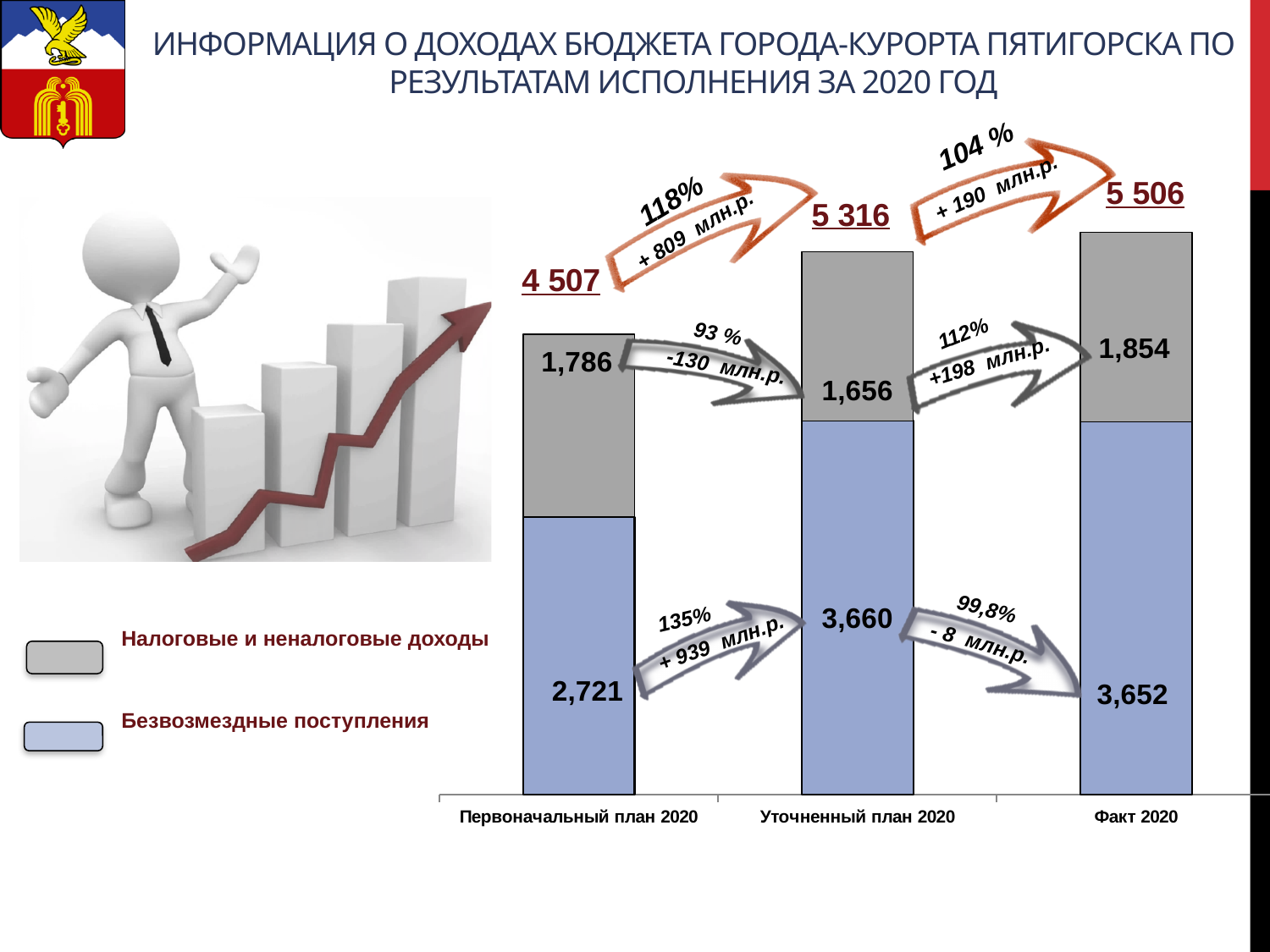
Which category has the lowest value for Безвозмездные поступления? Первоначальный план 2020 What is the value of Безвозмездные поступления for Уточненный план 2020? 3,660 Which category has the highest value for Налоговые и неналоговые доходы? Факт 2020 What is the total of the stacked bar for Факт 2020? 5 506 What is the total of the stacked bar for Первоначальный план 2020? 4 507 What type of chart is shown on the slide? stacked bar chart How many series does the legend list? 2 How many categories are shown along the x axis of the chart? 3 What is the value of Безвозмездные поступления for Факт 2020? 3,652 What is the difference between Налоговые и неналоговые доходы for Факт 2020 and for Уточненный план 2020? 198 What is the value of Налоговые и неналоговые доходы for Первоначальный план 2020? 1,786 Which is larger: Безвозмездные поступления for Уточненный план 2020 or for Факт 2020? Уточненный план 2020